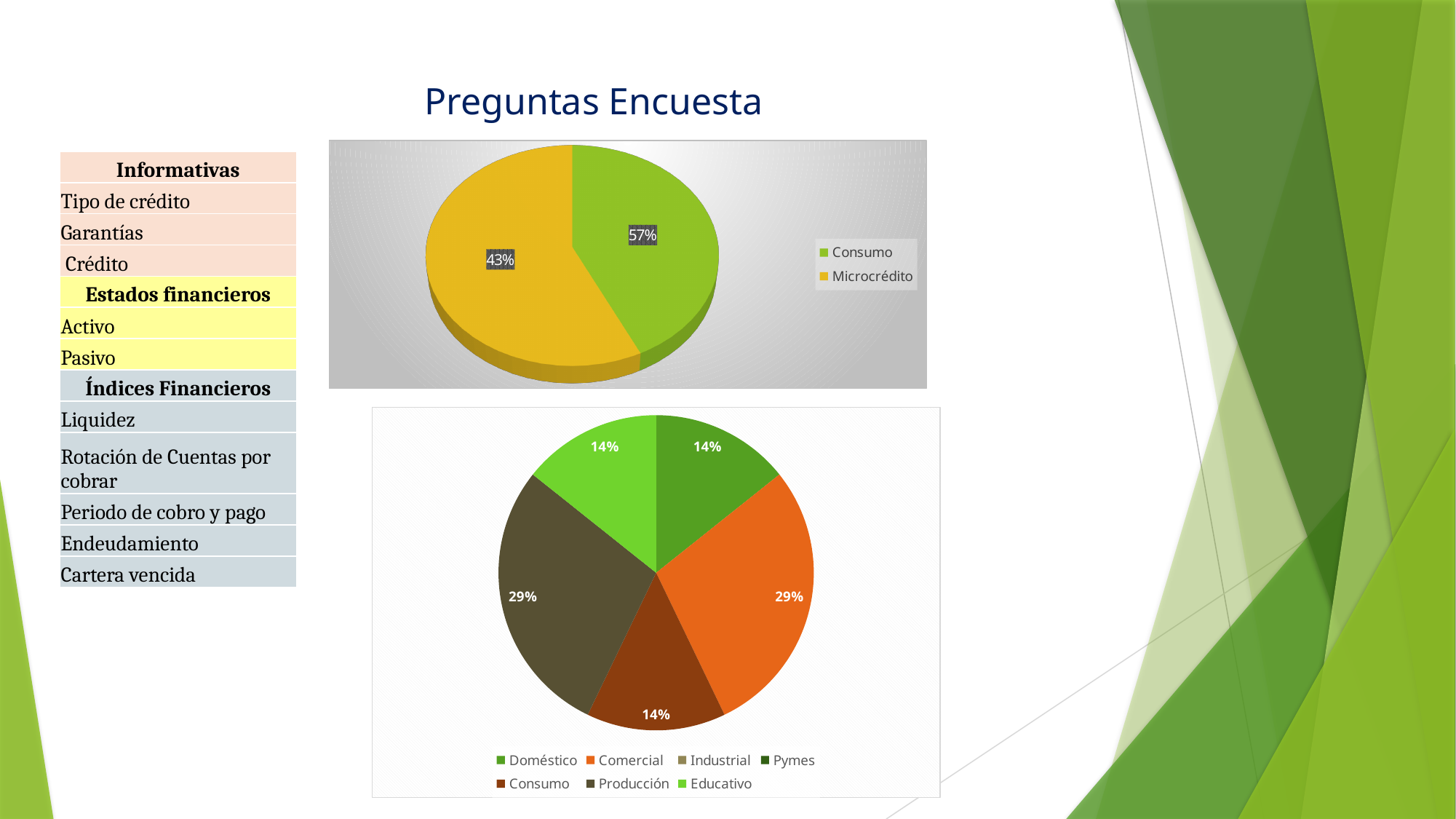
In the bottom pie chart, what share does Comercial have? 29% How many slices are visible in the bottom pie chart? 5 How many entries does the legend of the top pie chart list? 2 How many entries does the legend of the bottom pie chart list? 7 In the top pie chart, what is the difference between the Consumo and Microcrédito shares? 14% In the bottom pie chart, what share does Producción have? 29% In the top pie chart, what share does Consumo have? 57% What kind of chart is the top chart on the slide? Pie chart In the bottom pie chart, what share does Doméstico have? 14% In the bottom pie chart, which is larger, the Comercial share or the Educativo share? Comercial In the top pie chart, what share does Microcrédito have? 43%